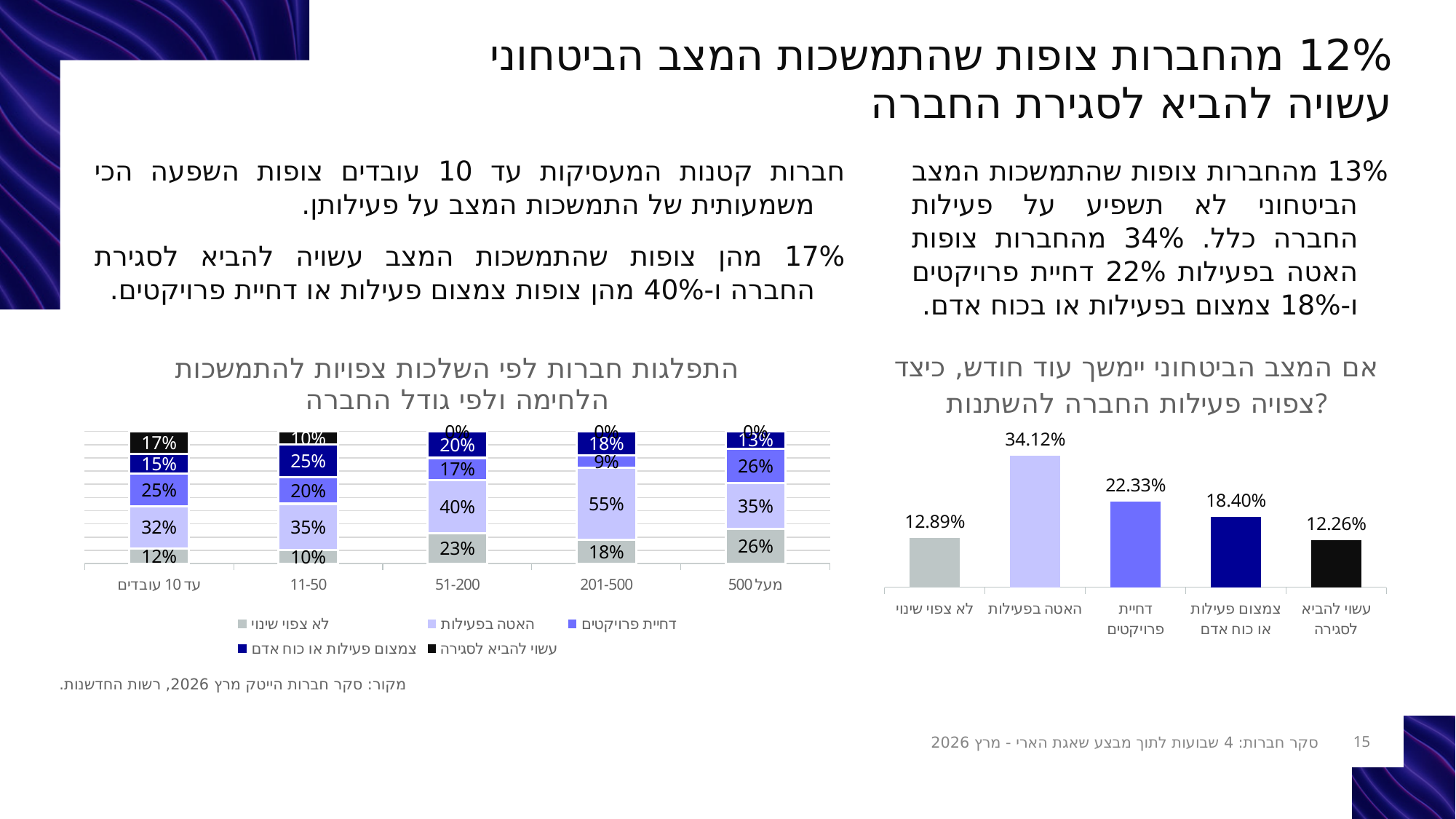
In the right chart (אם המצב הביטחוני יימשך עוד חודש), which category has the lowest value? עשוי להביא לסגירה In the left chart (התפלגות חברות לפי השלכות צפויות), how many series does the legend list? 5 In the left chart (התפלגות חברות לפי השלכות צפויות), what is the value of עשוי להביא לסגירה for עד 10 עובדים? 17% In the left chart (התפלגות חברות לפי השלכות צפויות), what is the difference between לא צפוי שינוי for 51-200 and for 11-50? 13% In the left chart (התפלגות חברות לפי השלכות צפויות), what is the value of האטה בפעילות for 201-500? 55% In the right chart (אם המצב הביטחוני יימשך עוד חודש), which category has the highest value? האטה בפעילות In the right chart (אם המצב הביטחוני יימשך עוד חודש), what is the value for האטה בפעילות? 34.12% In the left chart (התפלגות חברות לפי השלכות צפויות), which is larger for 11-50: האטה בפעילות or דחיית פרויקטים? האטה בפעילות In the right chart (אם המצב הביטחוני יימשך עוד חודש), how many categories are shown? 5 In the right chart (אם המצב הביטחוני יימשך עוד חודש), what is the difference between דחיית פרויקטים and צמצום פעילות או כוח אדם? 3.93% What kind of chart is the right chart (אם המצב הביטחוני יימשך עוד חודש)? Bar chart In the left chart (התפלגות חברות לפי השלכות צפויות), what is the value of לא צפוי שינוי for מעל 500? 26%